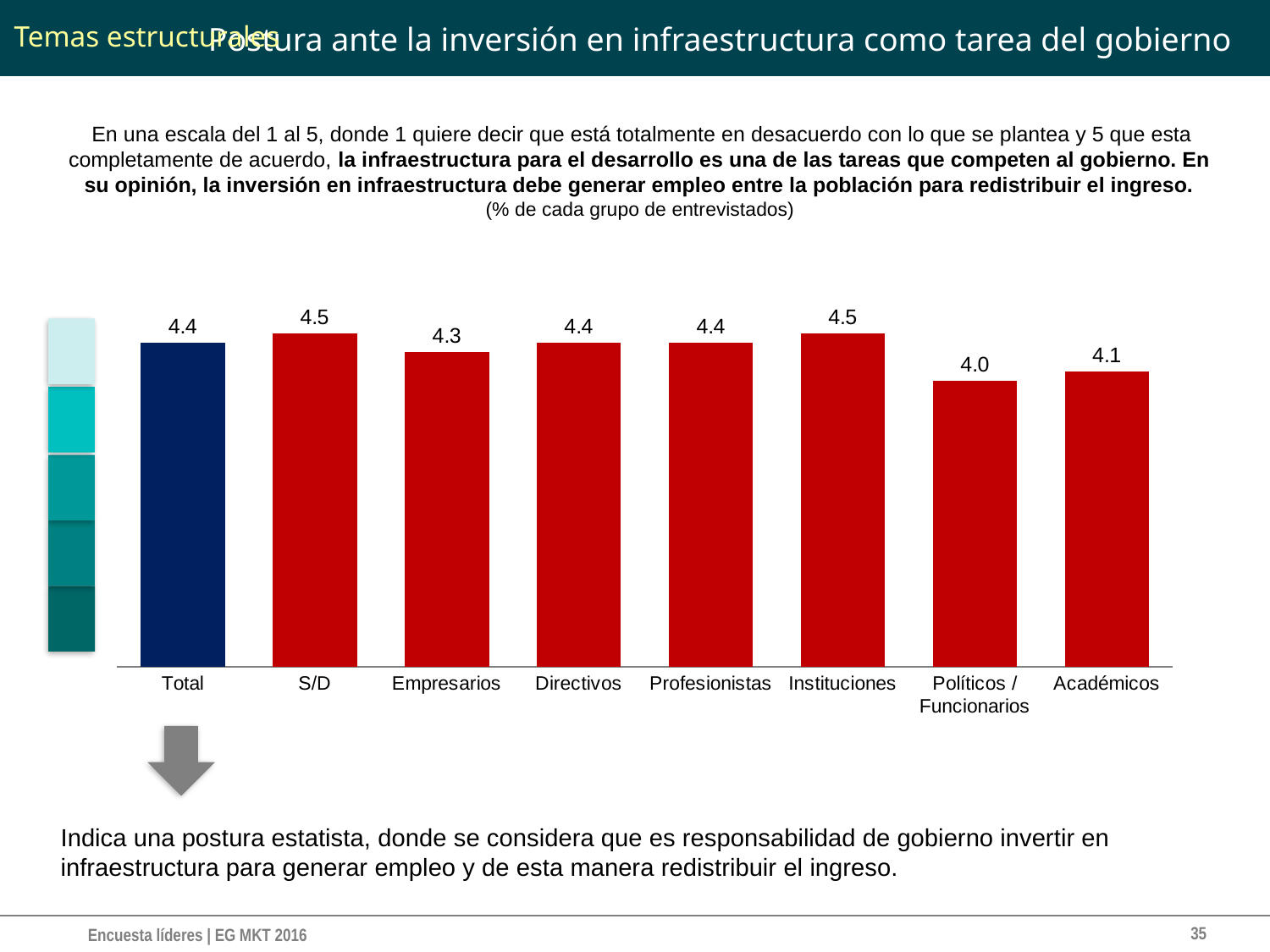
Which bar is coloured dark blue rather than red? Total Which category has the lowest value? Políticos / Funcionarios What is the value for Políticos / Funcionarios? 4.0 How many categories are shown on the x axis? 8 What kind of chart is shown on the slide? Bar chart What is the value for Empresarios? 4.3 What is the value for Instituciones? 4.5 What is the difference between the values for S/D and Políticos / Funcionarios? 0.5 What is the value for Total? 4.4 What is the value for Académicos? 4.1 What is the difference between the values for Total and Académicos? 0.3 Which is larger, the value for Instituciones or the value for Académicos? Instituciones